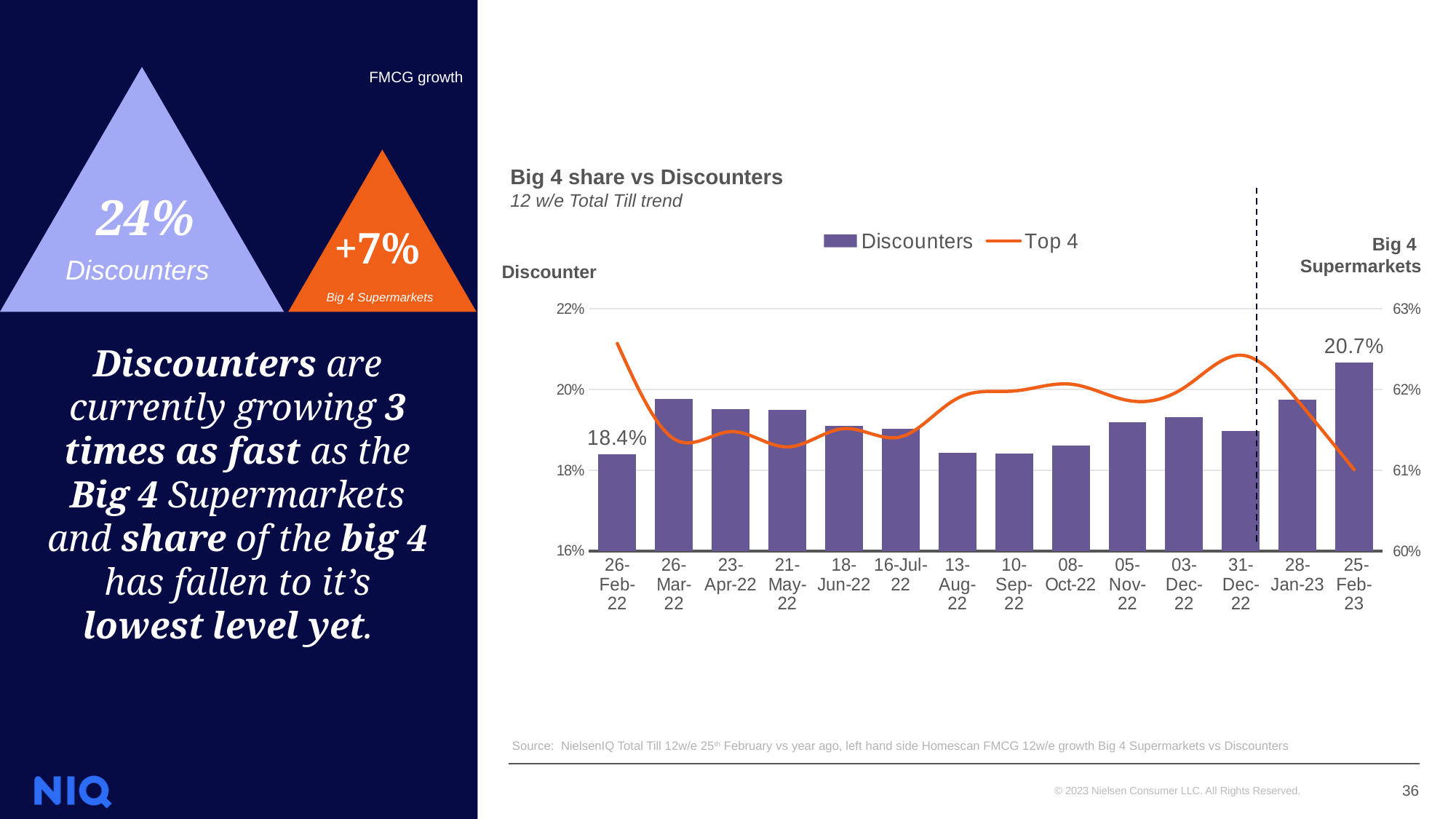
What are the two series named in the legend? Discounters and Top 4 By how many percentage points did the Discounters share rise from 26-Feb-22 to 25-Feb-23? 2.3 percentage points What is the Discounters value for 26-Feb-22? 18.4% Which is larger, the Discounters value for 26-Feb-22 or for 25-Feb-23? 25-Feb-23 How many series does the legend list? 2 Which period has the highest Discounters bar? 25-Feb-23 Does the Top 4 line rise or fall from 28-Jan-23 to 25-Feb-23? Fall What kind of chart is shown? A combination bar and line chart Is the Discounters value for 13-Aug-22 greater or less than 20%? less What is the Discounters value for 25-Feb-23? 20.7% Is the Top 4 value for 26-Feb-22 greater or less than 62%? greater How many periods are shown on the x axis? 14